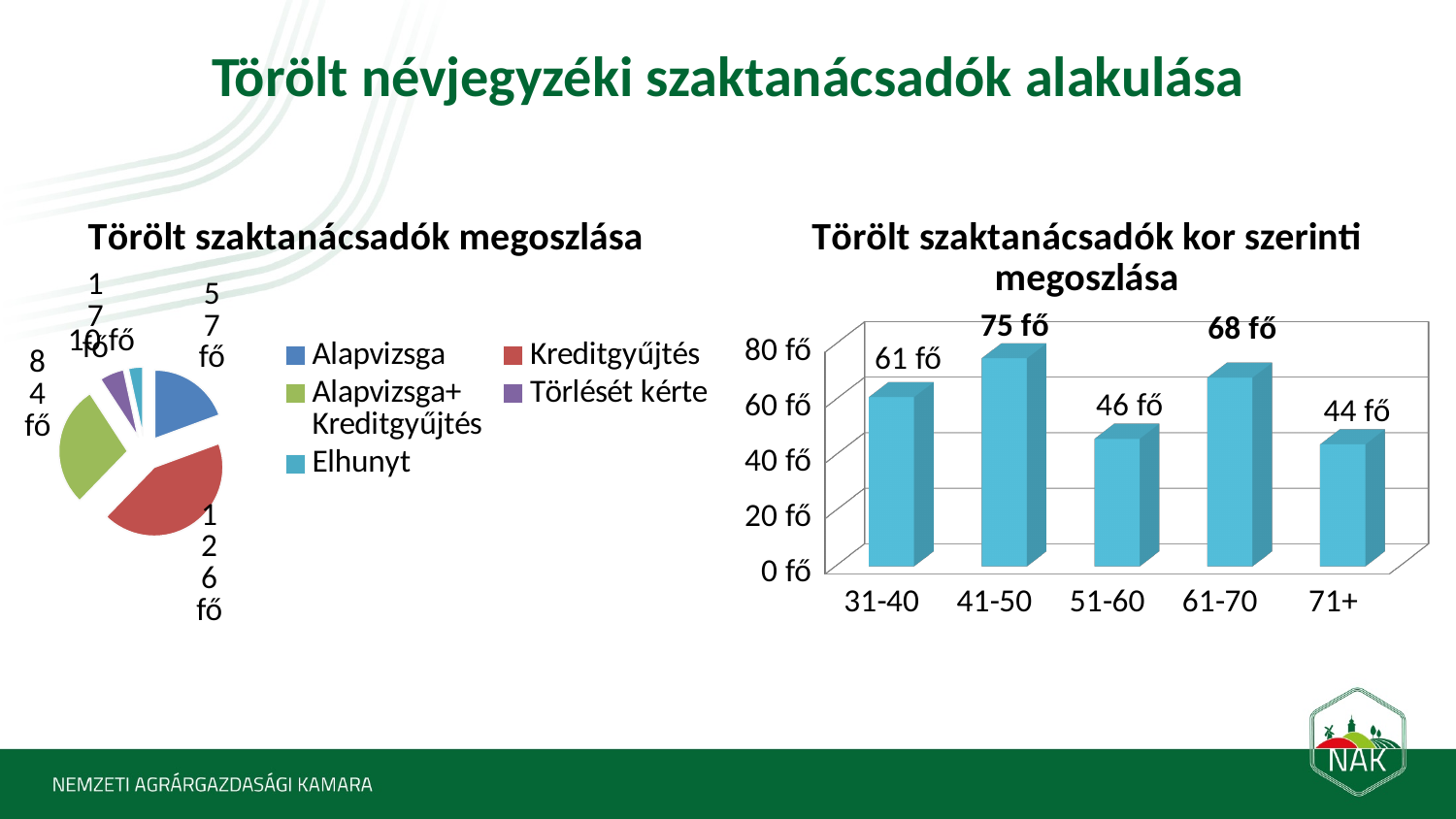
How many categories does the legend of the pie chart 'Törölt szaktanácsadók megoszlása' list? 5 In the bar chart 'Törölt szaktanácsadók kor szerinti megoszlása', which age group has the lowest value? 71+ In the pie chart 'Törölt szaktanácsadók megoszlása', what is the value for Alapvizsga? 57 fő What kind of chart is 'Törölt szaktanácsadók kor szerinti megoszlása'? bar chart In the bar chart 'Törölt szaktanácsadók kor szerinti megoszlása', what is the difference between the 41-50 and 51-60 age groups? 29 fő In the bar chart 'Törölt szaktanácsadók kor szerinti megoszlása', which age group has the highest value? 41-50 In the pie chart 'Törölt szaktanácsadók megoszlása', what is the value for Kreditgyűjtés? 126 fő In the pie chart 'Törölt szaktanácsadók megoszlása', which category has the largest slice? Kreditgyűjtés In the bar chart 'Törölt szaktanácsadók kor szerinti megoszlása', what is the value for the 41-50 age group? 75 fő In the bar chart 'Törölt szaktanácsadók kor szerinti megoszlása', which is larger, the value for 31-40 or for 61-70? 61-70 In the bar chart 'Törölt szaktanácsadók kor szerinti megoszlása', what is the value for the 71+ age group? 44 fő How many age groups are shown in the bar chart 'Törölt szaktanácsadók kor szerinti megoszlása'? 5